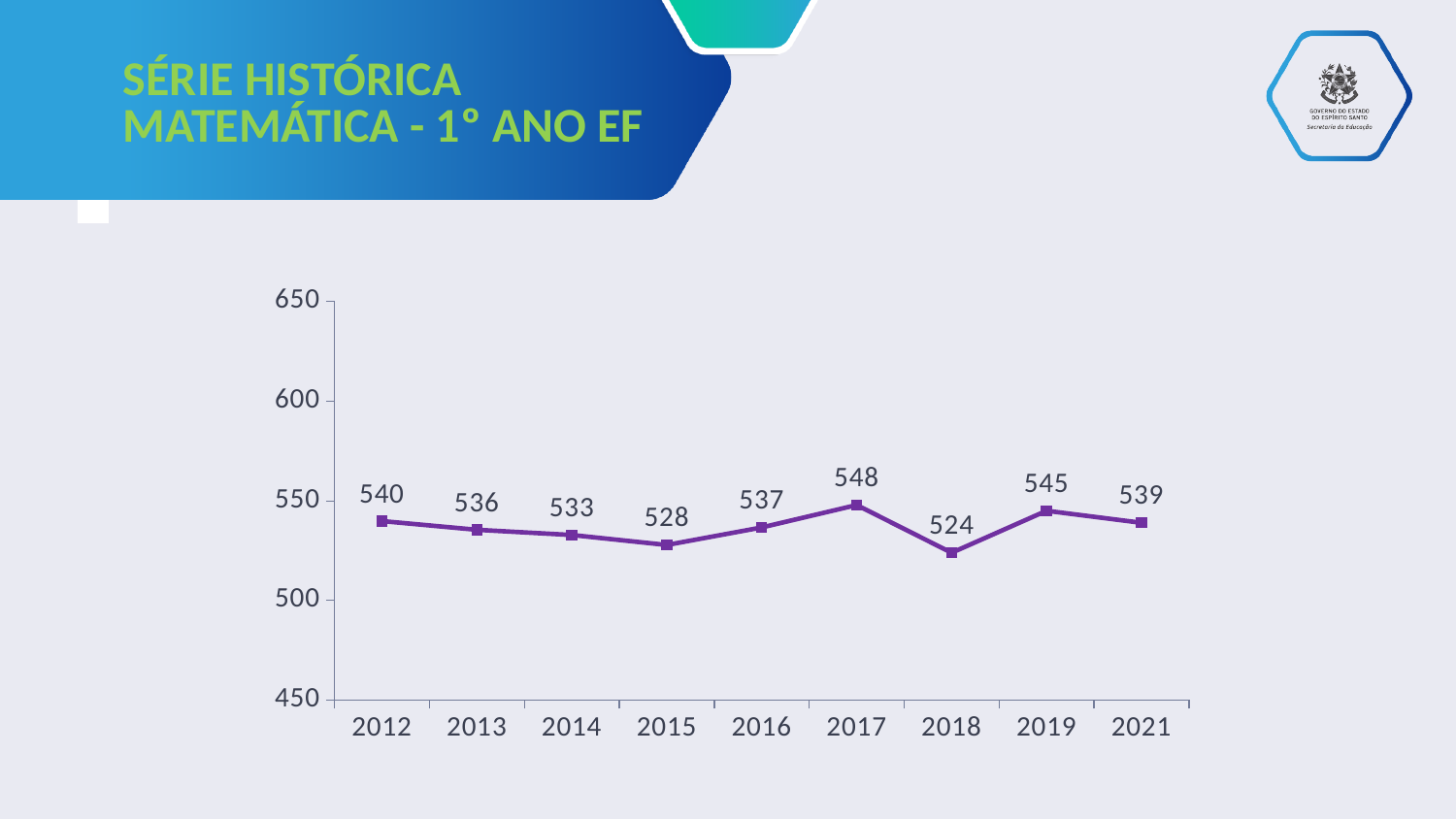
What is the value for 2021? 539 What kind of chart is shown on the slide? line chart Is the value for 2015 greater or less than 550? less What is the value for 2018? 524 Which is larger, the value for 2019 or the value for 2021? 2019 What is the title of the slide? SÉRIE HISTÓRICA MATEMÁTICA - 1° ANO EF How many years are plotted on the chart? 9 Which year has the lowest value? 2018 What is the value for 2012? 540 What is the difference between the values for 2017 and 2018? 24 Do the values rise or fall from 2012 to 2015? fall Which year has the highest value? 2017